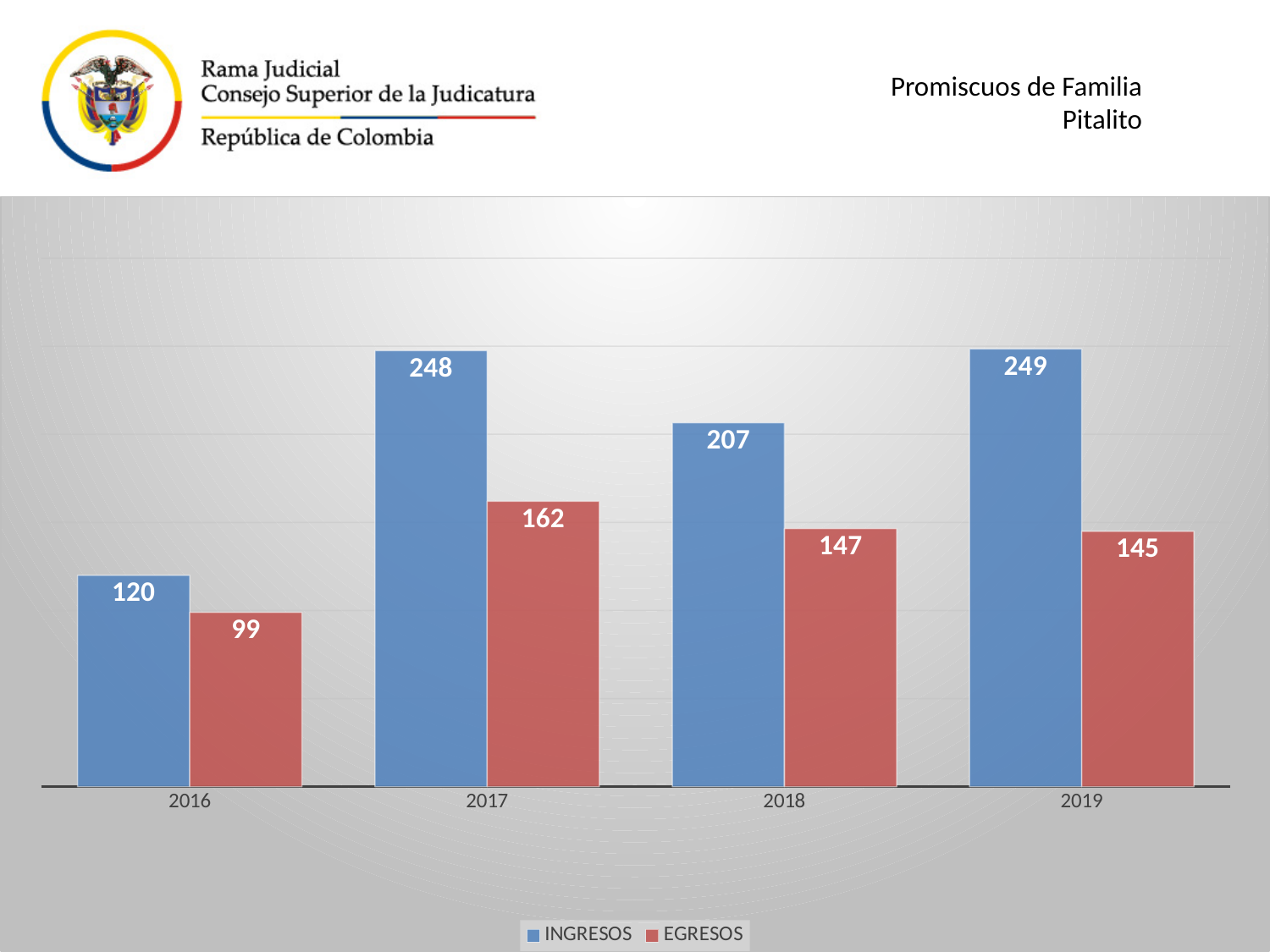
What is the EGRESOS value for 2019? 145 What is the INGRESOS value for 2016? 120 Which year has the lowest INGRESOS value? 2016 How many series does the legend list? 2 What is the INGRESOS value for 2017? 248 What is the difference between the EGRESOS values for 2016 and 2018? 48 What is the EGRESOS value for 2018? 147 What kind of chart is shown on the slide? bar chart What is the difference between INGRESOS and EGRESOS in 2017? 86 How many years are shown on the x axis? 4 Which is larger, INGRESOS in 2018 or EGRESOS in 2017? INGRESOS in 2018 Which year has the highest EGRESOS value? 2017